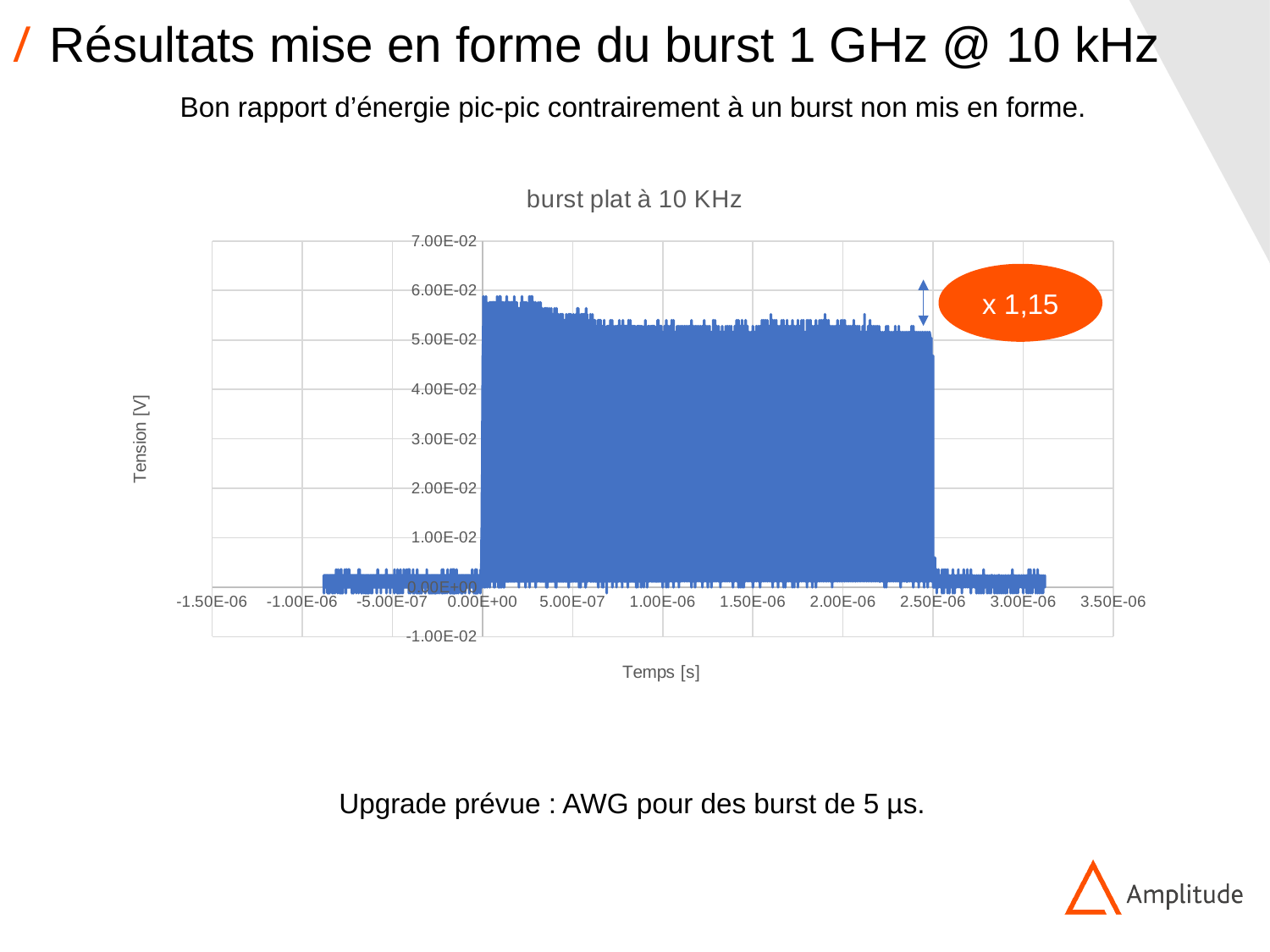
Is the peak value of the signal near 0.00E+00 s greater or less than 5.00E-02? greater Does the upper envelope of the burst rise or fall between 0.00E+00 s and 2.50E-06 s? fall What is the highest tick value shown on the vertical axis of the chart? 7.00E-02 What is the lowest tick value shown on the horizontal axis of the chart? -1.50E-06 Is the peak value of the signal at 2.00E-06 s greater or less than 4.00E-02? greater What is the label of the vertical axis of the chart? Tension [V] Is the value of the signal at 3.00E-06 s greater or less than 1.00E-02? less What kind of chart is shown on the slide? line chart